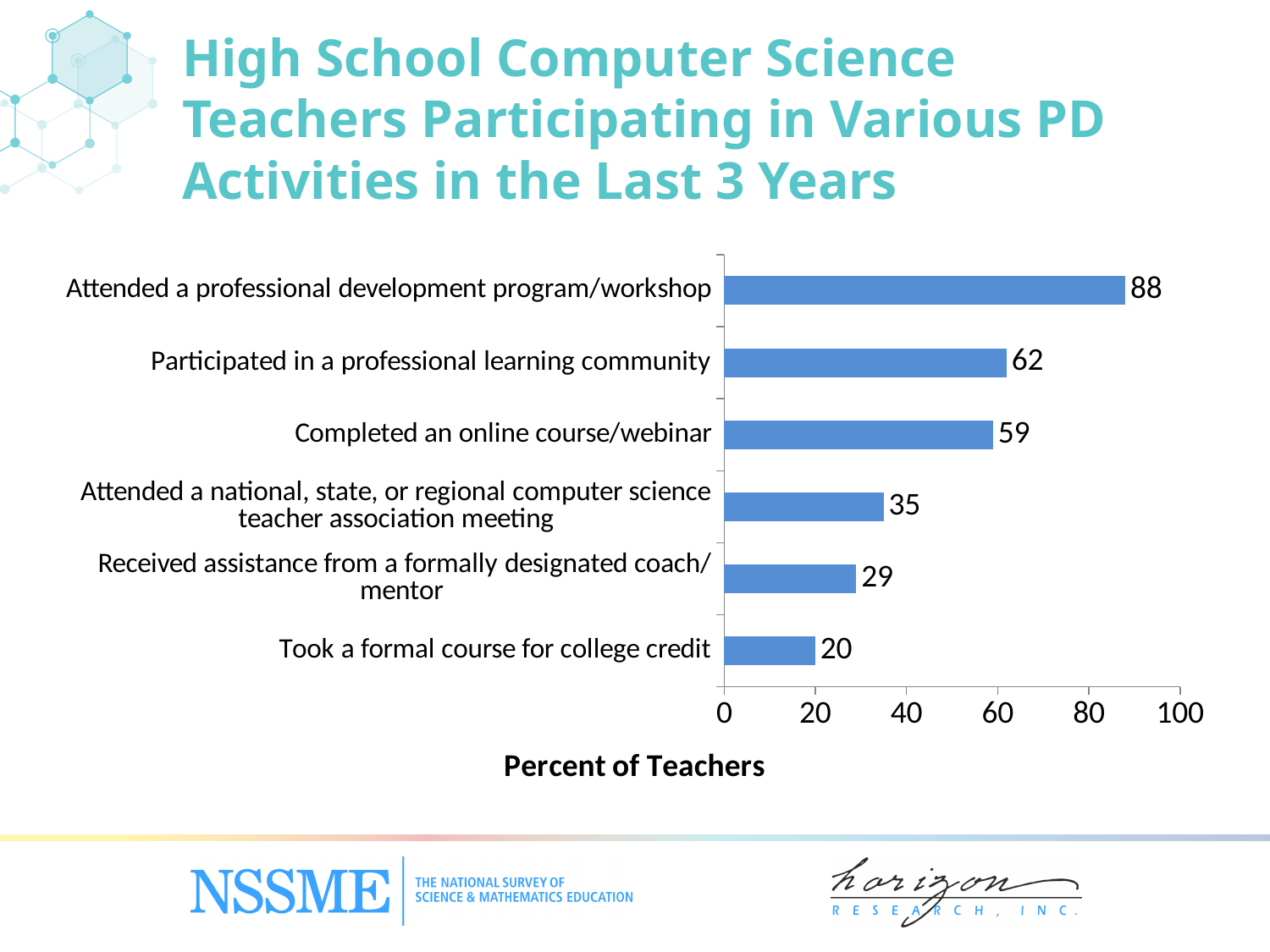
What percent of teachers attended a professional development program/workshop? 88 What is the label of the horizontal axis? Percent of Teachers Is the value for attending a national, state, or regional computer science teacher association meeting greater or less than 40? less Which PD activity has the lowest percent of teachers? Took a formal course for college credit What is the maximum value shown on the horizontal axis? 100 What is the difference in percent of teachers between participating in a professional learning community and taking a formal course for college credit? 42 What kind of chart is shown on the slide? Bar chart What percent of teachers completed an online course/webinar? 59 What percent of teachers received assistance from a formally designated coach/mentor? 29 Which PD activity has the highest percent of teachers? Attended a professional development program/workshop How many PD activities are shown in the chart? 6 Which has a higher percent of teachers: attending a national, state, or regional computer science teacher association meeting, or completing an online course/webinar? Completed an online course/webinar